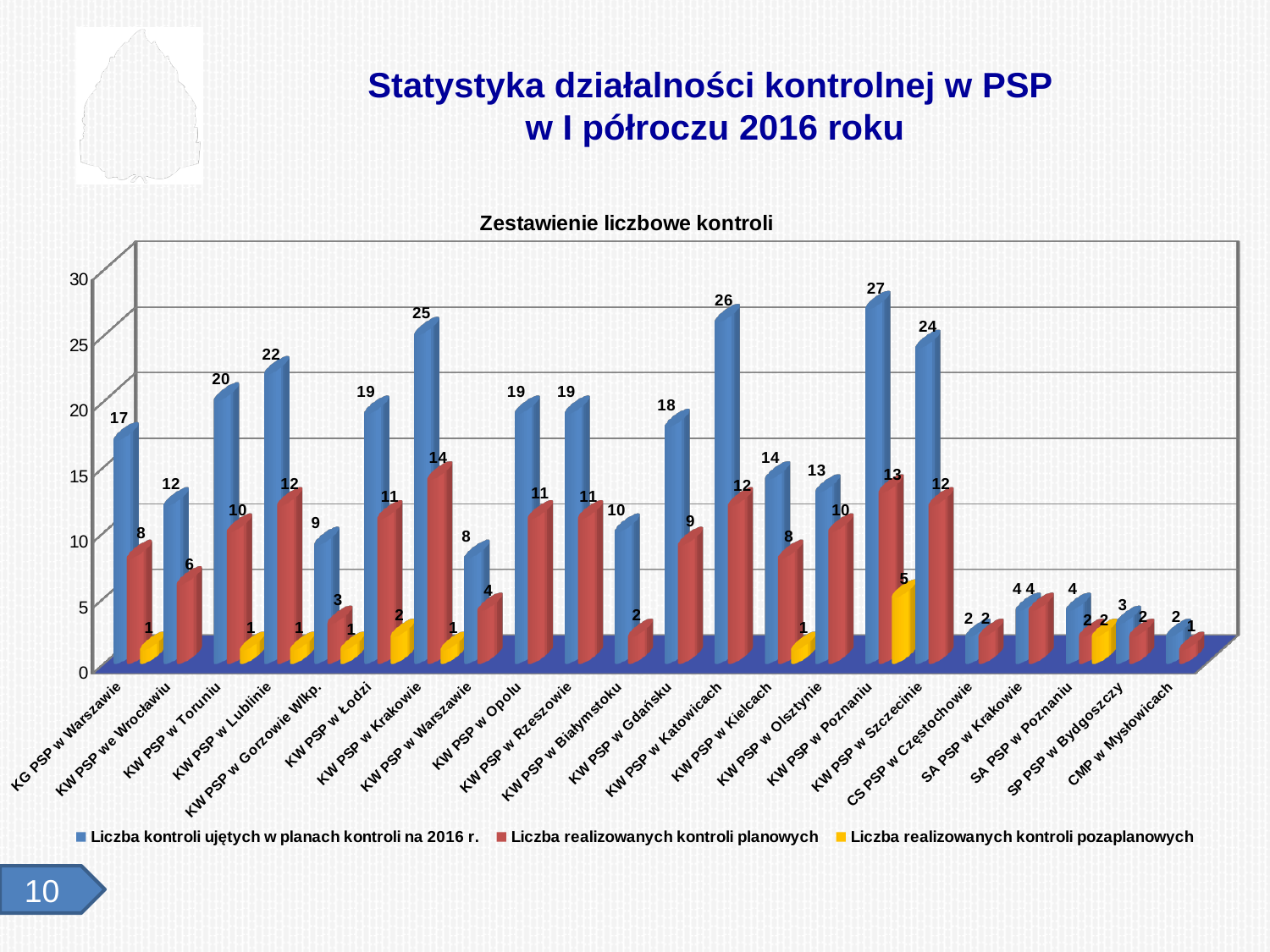
What is the value of 'Liczba realizowanych kontroli pozaplanowych' for KW PSP w Poznaniu? 5 Which unit has the highest value for 'Liczba realizowanych kontroli planowych'? KW PSP w Krakowie Is the value of 'Liczba kontroli ujętych w planach kontroli na 2016 r.' for KW PSP w Gdańsku greater or less than 15? greater How many categories (units) are shown on the x axis? 22 What is the difference between the planned controls (blue) and realized planned controls (red) for KW PSP w Katowicach? 14 Which is larger: the planned controls value for KW PSP w Szczecinie or for KW PSP w Lublinie? KW PSP w Szczecinie How many series does the legend list? 3 What is the title of the chart? Zestawienie liczbowe kontroli Which unit has the highest value for 'Liczba kontroli ujętych w planach kontroli na 2016 r.'? KW PSP w Poznaniu What is the value of 'Liczba realizowanych kontroli planowych' for KW PSP w Lublinie? 12 What is the value of 'Liczba kontroli ujętych w planach kontroli na 2016 r.' for KW PSP w Krakowie? 25 What type of chart is shown on the slide? bar chart